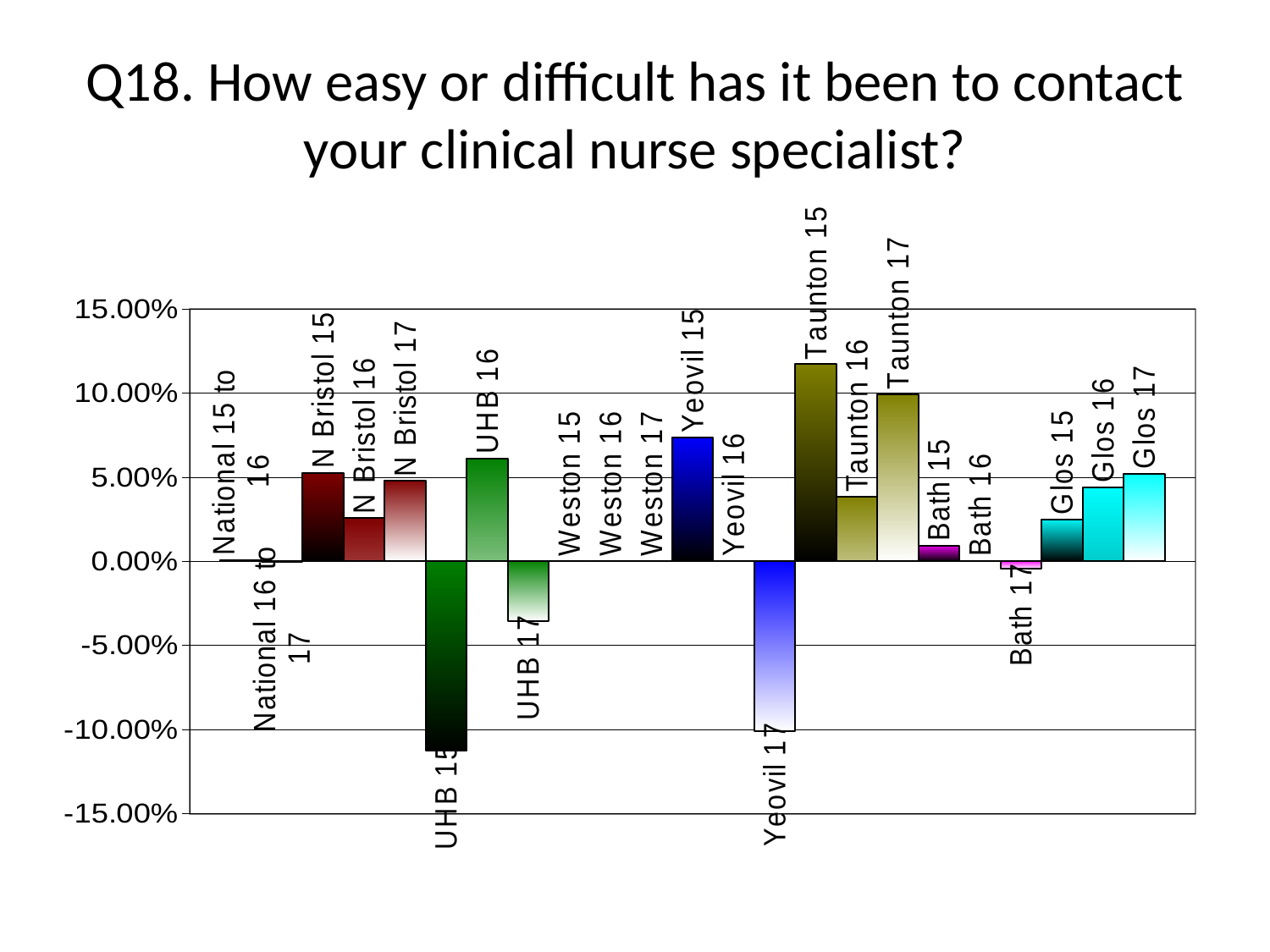
Do the Glos values rise or fall from Glos 15 to Glos 17? rise Is the value for UHB 17 greater or less than -5.00%? greater Is the value for Taunton 15 greater or less than 10.00%? greater Which category has the highest value in the chart? Taunton 15 Is the value for Yeovil 15 greater or less than 5.00%? greater Which is larger, the value for Glos 15 or Glos 16? Glos 16 What is the title of the chart? Q18. How easy or difficult has it been to contact your clinical nurse specialist? What kind of chart is shown on the slide? bar chart Which is larger, the value for Taunton 15 or Taunton 16? Taunton 15 Which category has the lowest value in the chart? UHB 15